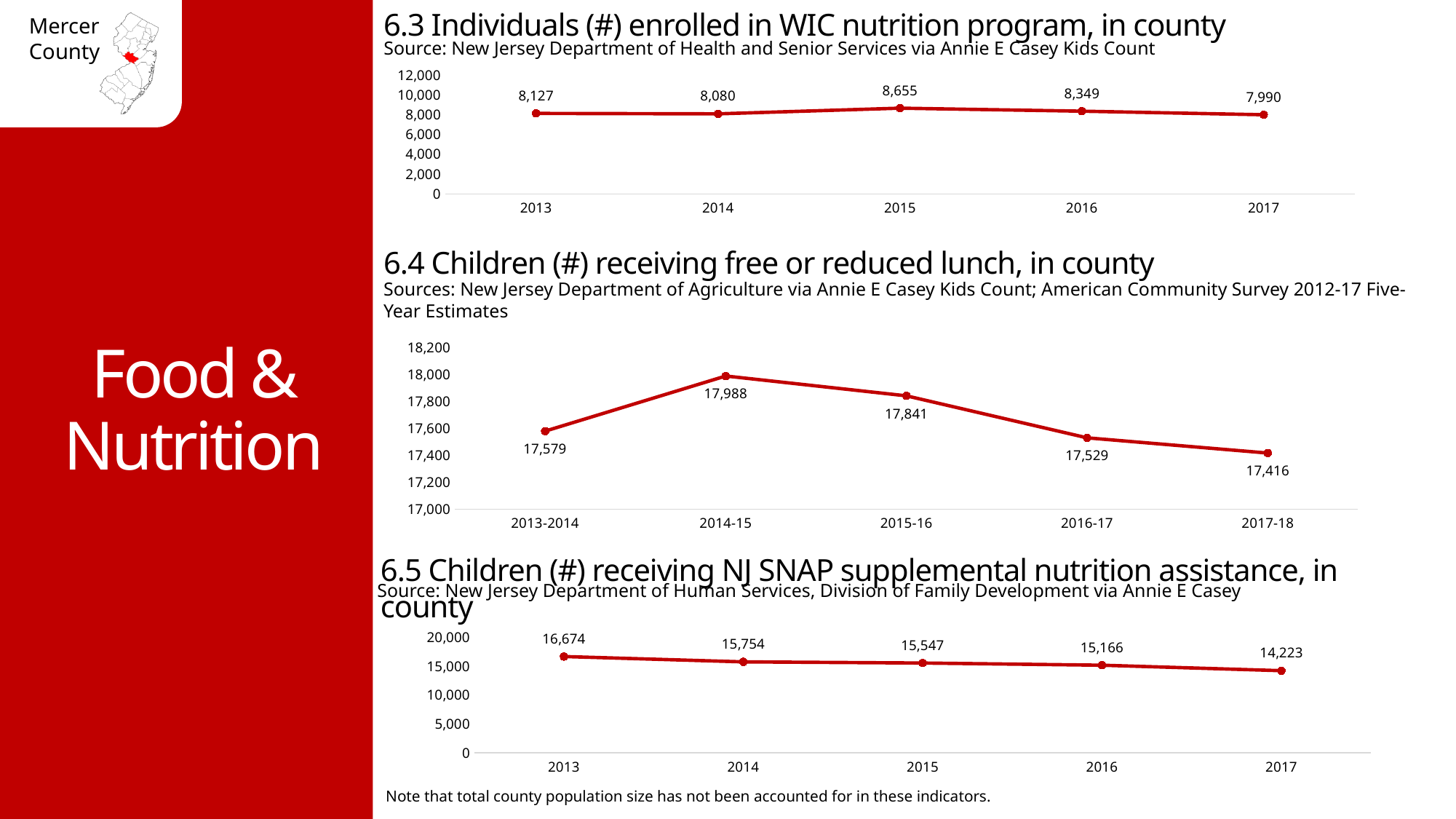
In the chart '6.4 Children (#) receiving free or reduced lunch, in county', which is larger: the value for 2013-2014 or the value for 2017-18? 2013-2014 In the chart '6.5 Children (#) receiving NJ SNAP supplemental nutrition assistance, in county', do the values rise or fall from 2013 to 2017? Fall In the chart '6.4 Children (#) receiving free or reduced lunch, in county', what is the difference between the 2014-15 and 2016-17 values? 459 In the chart '6.4 Children (#) receiving free or reduced lunch, in county', which school year has the highest value? 2014-15 In the chart '6.5 Children (#) receiving NJ SNAP supplemental nutrition assistance, in county', what is the value for 2013? 16,674 In the chart '6.3 Individuals (#) enrolled in WIC nutrition program, in county', which year has the lowest value? 2017 In the chart '6.5 Children (#) receiving NJ SNAP supplemental nutrition assistance, in county', what is the difference between the 2013 and 2017 values? 2,451 In the chart '6.3 Individuals (#) enrolled in WIC nutrition program, in county', what is the difference between the 2015 and 2017 values? 665 In the chart '6.4 Children (#) receiving free or reduced lunch, in county', what is the value for 2014-15? 17,988 In the chart '6.3 Individuals (#) enrolled in WIC nutrition program, in county', what is the value for 2015? 8,655 What kind of chart is '6.4 Children (#) receiving free or reduced lunch, in county'? Line chart In the chart '6.3 Individuals (#) enrolled in WIC nutrition program, in county', how many years are plotted? 5